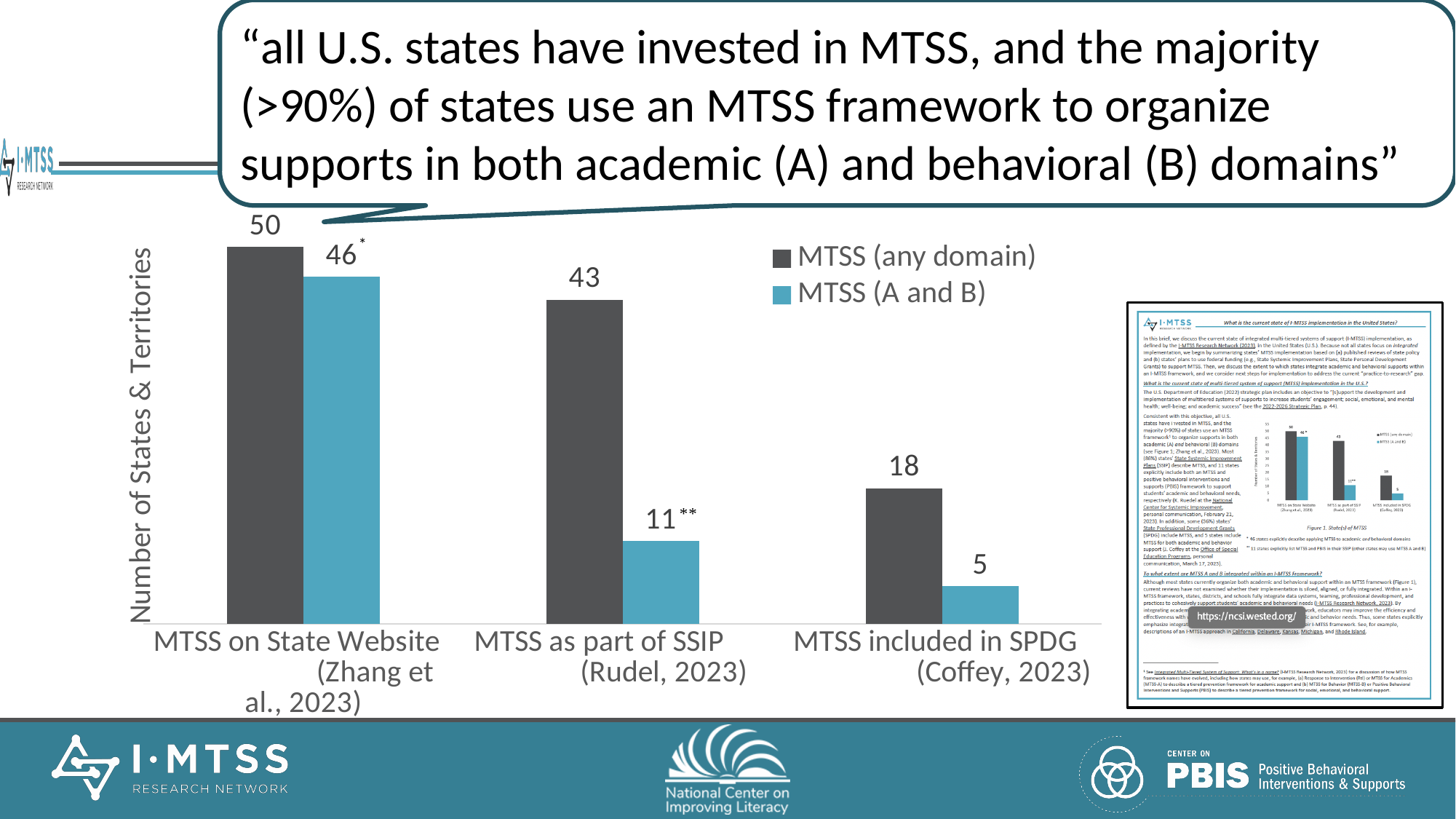
What kind of chart is shown? Bar chart Which category has the lowest MTSS (A and B) value? MTSS included in SPDG (Coffey, 2023) What is the value of MTSS (any domain) for MTSS included in SPDG (Coffey, 2023)? 18 What is the difference between MTSS (any domain) and MTSS (A and B) for MTSS as part of SSIP (Rudel, 2023)? 32 What is the value of MTSS (A and B) for MTSS as part of SSIP (Rudel, 2023)? 11 What is the label of the y axis? Number of States & Territories How many series does the legend list? 2 Which category has the highest MTSS (any domain) value? MTSS on State Website (Zhang et al., 2023) What is the value of MTSS (any domain) for MTSS on State Website (Zhang et al., 2023)? 50 How many categories are shown on the x axis? 3 Which is larger: MTSS (A and B) for MTSS on State Website or MTSS (any domain) for MTSS as part of SSIP? MTSS (A and B) for MTSS on State Website What is the value of MTSS (A and B) for MTSS included in SPDG (Coffey, 2023)? 5